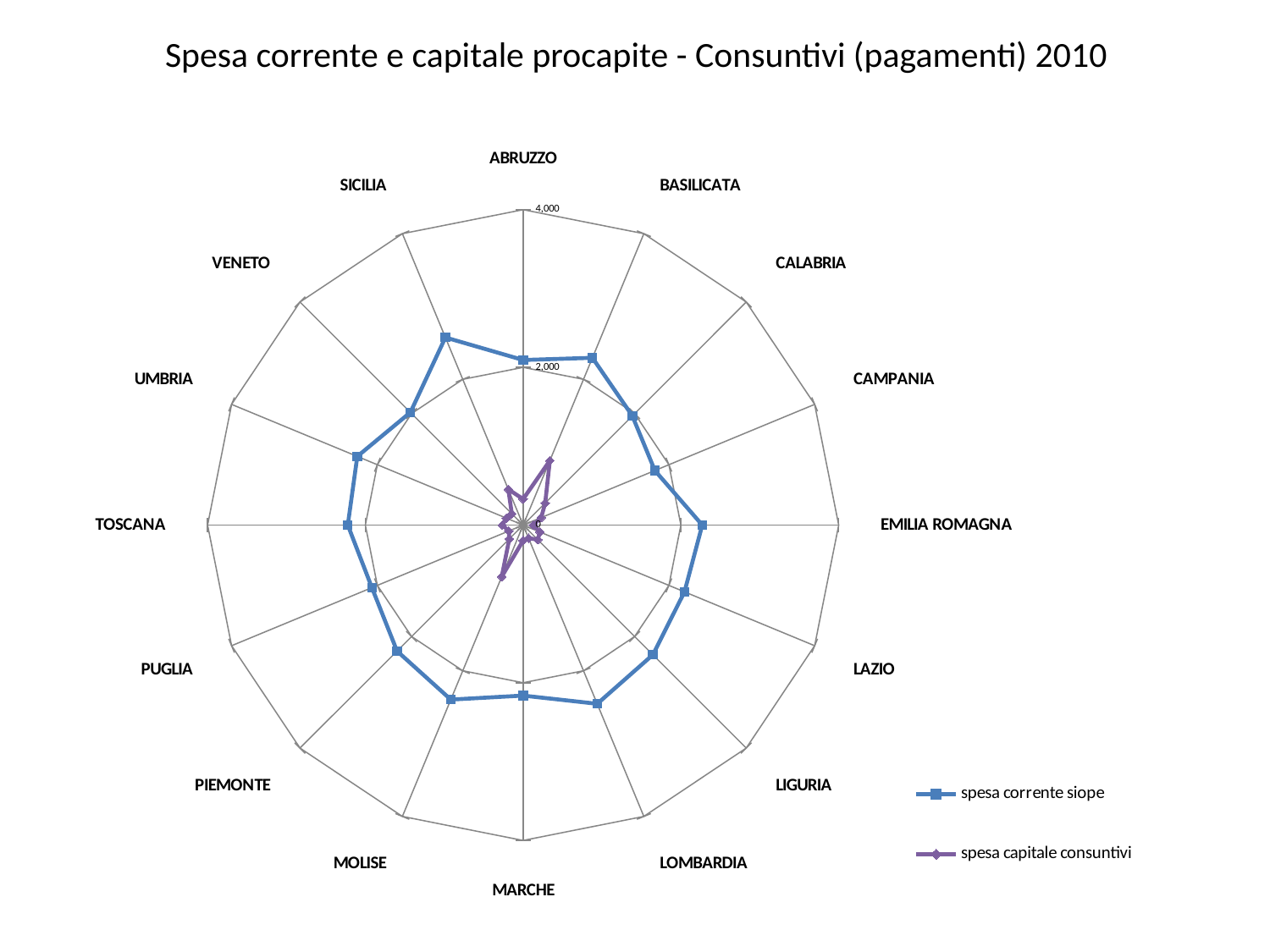
Which region has the highest value for spesa corrente siope? SICILIA What kind of chart is shown on the slide? Radar chart Is the spesa corrente siope value for VENETO greater or less than 4,000? less What is the title of the chart? Spesa corrente e capitale procapite - Consuntivi (pagamenti) 2010 Is the spesa capitale consuntivi value for TOSCANA greater or less than 2,000? less Is the spesa corrente siope value for SICILIA greater or less than 2,000? greater Which region has the larger spesa corrente siope value, SICILIA or CAMPANIA? SICILIA How many series does the legend list? 2 Which is larger for SICILIA: spesa corrente siope or spesa capitale consuntivi? spesa corrente siope How many regions (categories) are plotted on the radar chart? 16 Which series is drawn in blue with square markers? spesa corrente siope